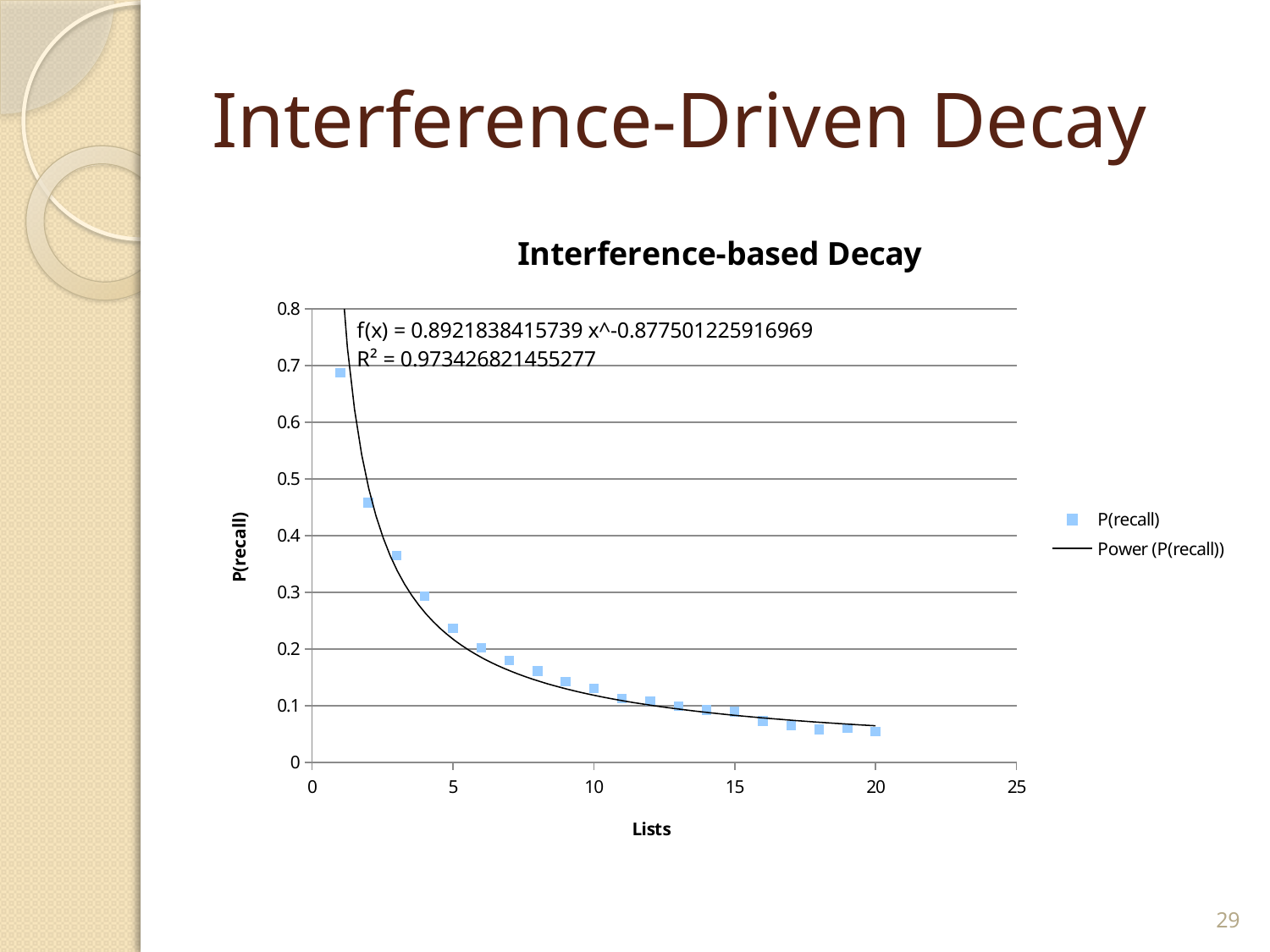
Is the P(recall) value at Lists = 5 greater or less than 0.2? greater What is the title of the chart? Interference-based Decay At which value of Lists is P(recall) highest? 1 Is the P(recall) value at Lists = 1 greater or less than 0.6? greater Is the P(recall) value at Lists = 3 greater or less than 0.4? less How many data points are plotted for P(recall)? 20 Which has a larger P(recall) value: Lists = 2 or Lists = 5? Lists = 2 What R² value is printed on the chart for the power trendline? 0.973426821455277 How many entries does the chart legend list? 2 Do the P(recall) values rise or fall as Lists increases? fall What kind of chart is shown on the slide? scatter chart